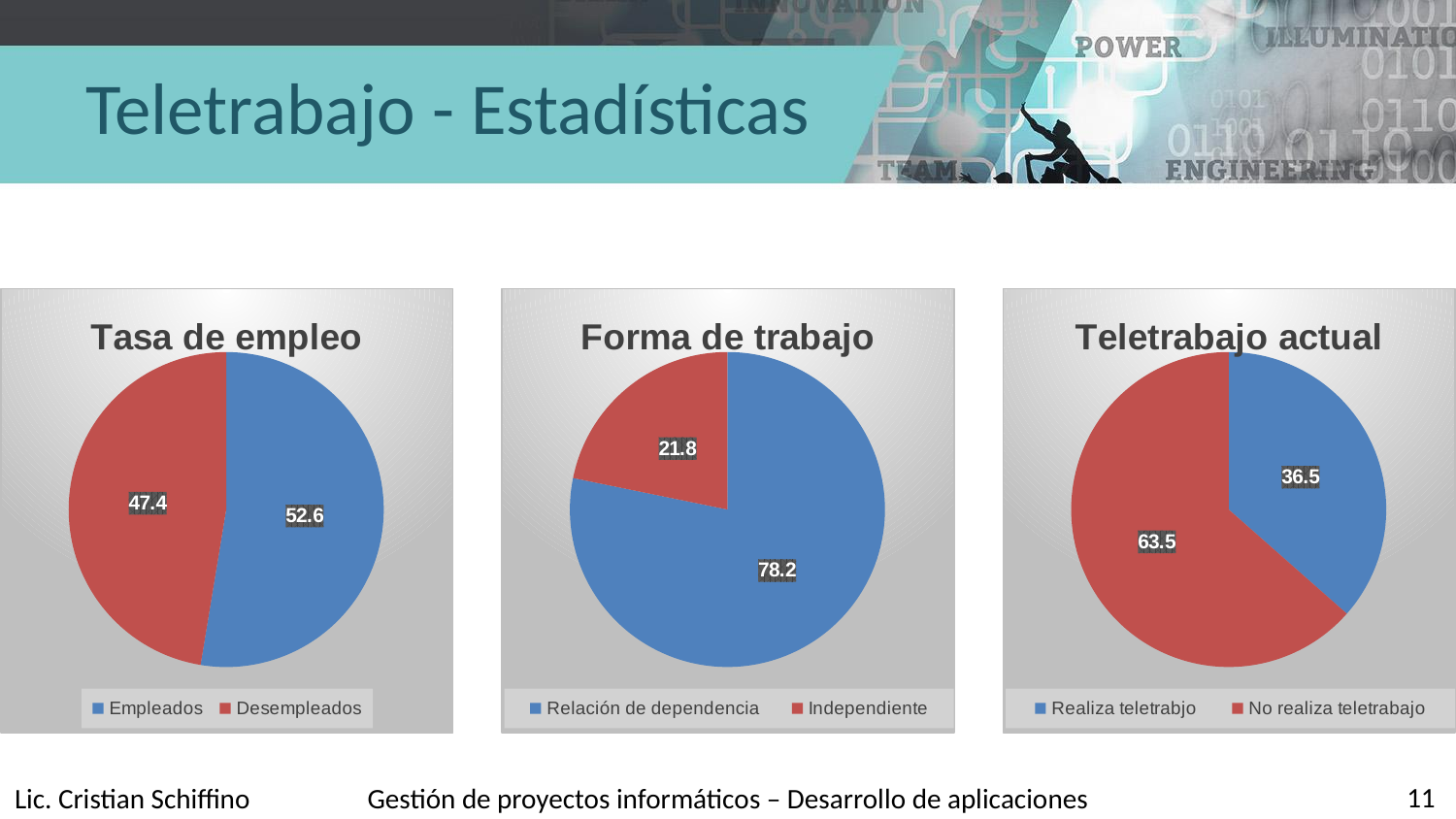
How many slices does the 'Tasa de empleo' pie chart have? 2 In the 'Tasa de empleo' chart, what is the value for Desempleados? 47.4 What kind of chart is 'Forma de trabajo'? Pie chart In the 'Forma de trabajo' chart, what is the value for Independiente? 21.8 In the 'Teletrabajo actual' chart, what is the difference between No realiza teletrabajo and Realiza teletrabajo? 27 In the 'Forma de trabajo' chart, which category has the smallest slice? Independiente In the 'Tasa de empleo' chart, which is larger, Empleados or Desempleados? Empleados In the 'Tasa de empleo' chart, what is the value for Empleados? 52.6 In the 'Teletrabajo actual' chart, which category has the largest slice? No realiza teletrabajo In the 'Forma de trabajo' chart, what is the value for Relación de dependencia? 78.2 In the 'Teletrabajo actual' chart, what is the value for No realiza teletrabajo? 63.5 In the 'Forma de trabajo' chart, what is the difference between Relación de dependencia and Independiente? 56.4